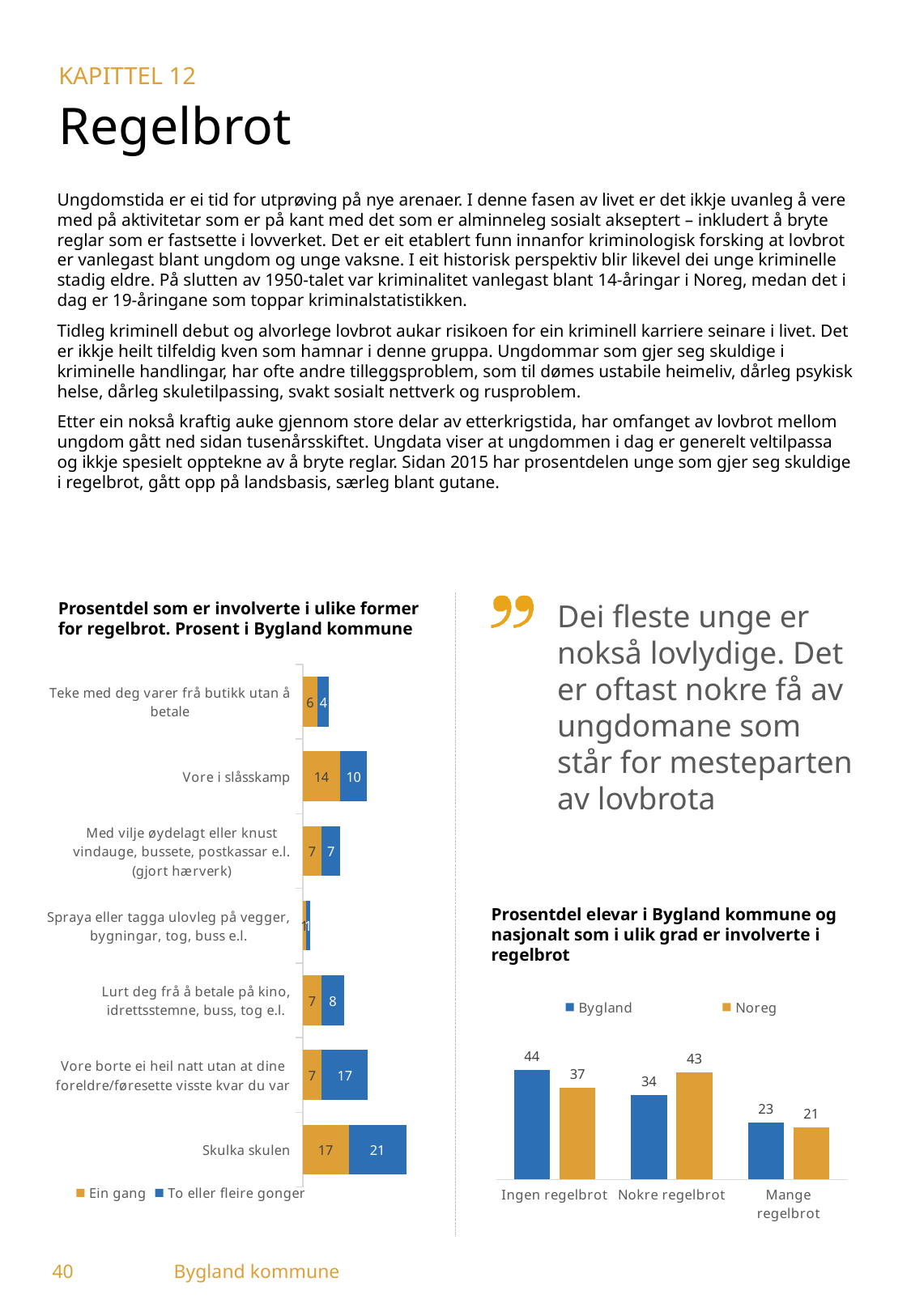
In the chart 'Prosentdel som er involverte i ulike former for regelbrot', what is the 'To eller fleire gonger' value for 'Vore borte ei heil natt utan at dine foreldre/føresette visste kvar du var'? 17 In the chart 'Prosentdel som er involverte i ulike former for regelbrot', what is the total of the stacked bar for 'Skulka skulen'? 38 What kind of chart is 'Prosentdel elevar i Bygland kommune og nasjonalt som i ulik grad er involverte i regelbrot'? Bar chart In the chart 'Prosentdel som er involverte i ulike former for regelbrot', how many categories are shown? 7 In the chart 'Prosentdel elevar i Bygland kommune og nasjonalt som i ulik grad er involverte i regelbrot', what is the Bygland value for 'Ingen regelbrot'? 44 In the chart 'Prosentdel som er involverte i ulike former for regelbrot', what is the 'Ein gang' value for 'Skulka skulen'? 17 In the chart 'Prosentdel elevar i Bygland kommune og nasjonalt som i ulik grad er involverte i regelbrot', what is the Noreg value for 'Nokre regelbrot'? 43 In the chart 'Prosentdel elevar i Bygland kommune og nasjonalt som i ulik grad er involverte i regelbrot', which is larger for 'Mange regelbrot': Bygland or Noreg? Bygland In the chart 'Prosentdel som er involverte i ulike former for regelbrot', what is the total of the stacked bar for 'Vore i slåsskamp'? 24 In the chart 'Prosentdel som er involverte i ulike former for regelbrot', which category has the largest total bar? Skulka skulen In the chart 'Prosentdel som er involverte i ulike former for regelbrot', how many series does the legend list? 2 In the chart 'Prosentdel elevar i Bygland kommune og nasjonalt som i ulik grad er involverte i regelbrot', what is the difference between the Bygland and Noreg values for 'Ingen regelbrot'? 7